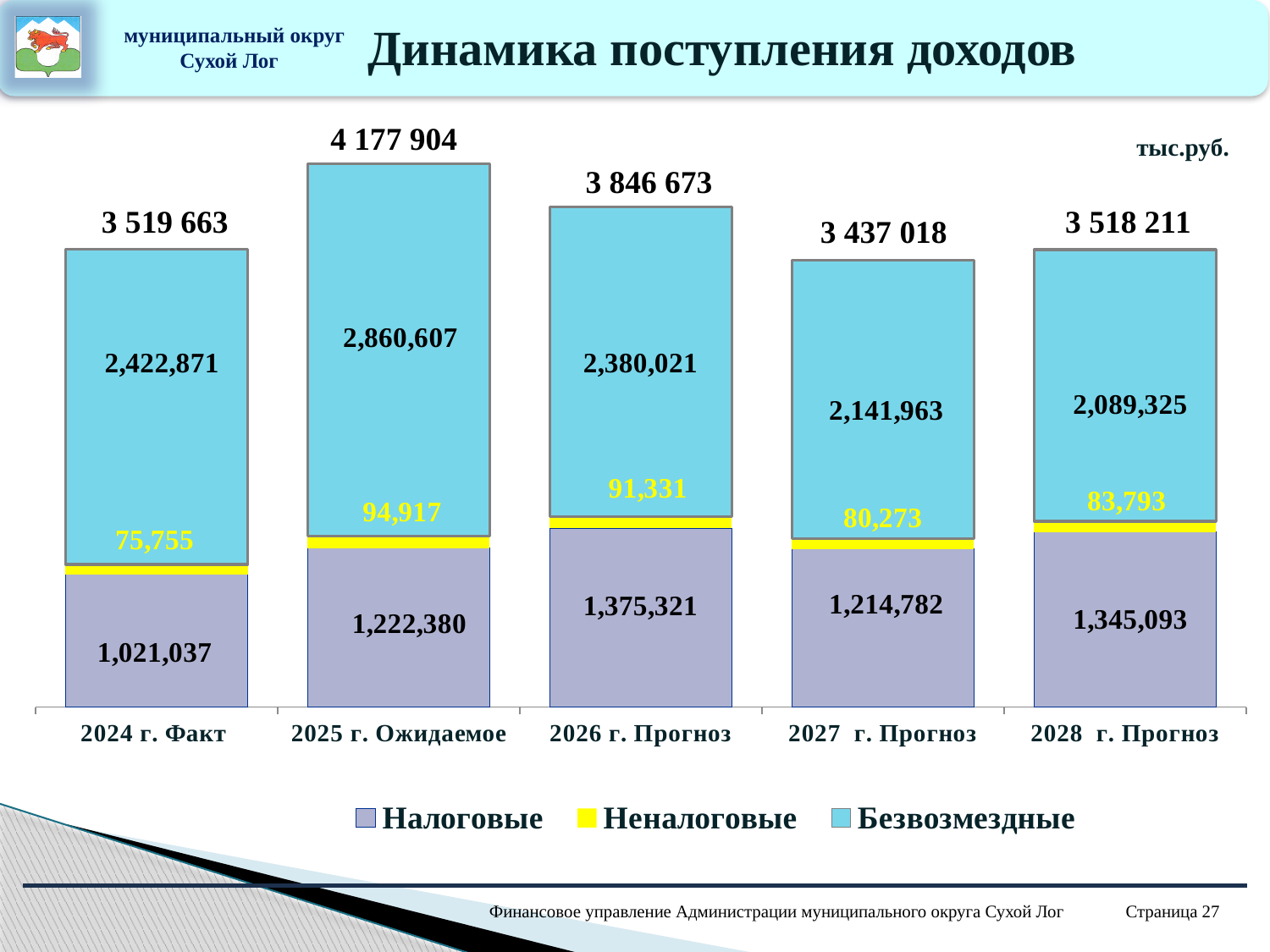
What type of chart is shown on the slide? stacked bar chart What unit of measurement is indicated on the chart? тыс.руб. What is the total of the stacked bar for 2026 г. Прогноз? 3 846 673 What is the value of Неналоговые for 2027 г. Прогноз? 80,273 What is the value of Безвозмездные for 2025 г. Ожидаемое? 2,860,607 How many categories (years) are shown on the x axis? 5 What is the value of Налоговые for 2024 г. Факт? 1,021,037 What is the difference between Налоговые in 2026 г. Прогноз and 2027 г. Прогноз? 160,539 Which is larger: Безвозмездные in 2024 г. Факт or in 2028 г. Прогноз? 2024 г. Факт Which year has the highest total revenue? 2025 г. Ожидаемое Which year has the lowest total revenue? 2027 г. Прогноз How many series does the legend list? 3